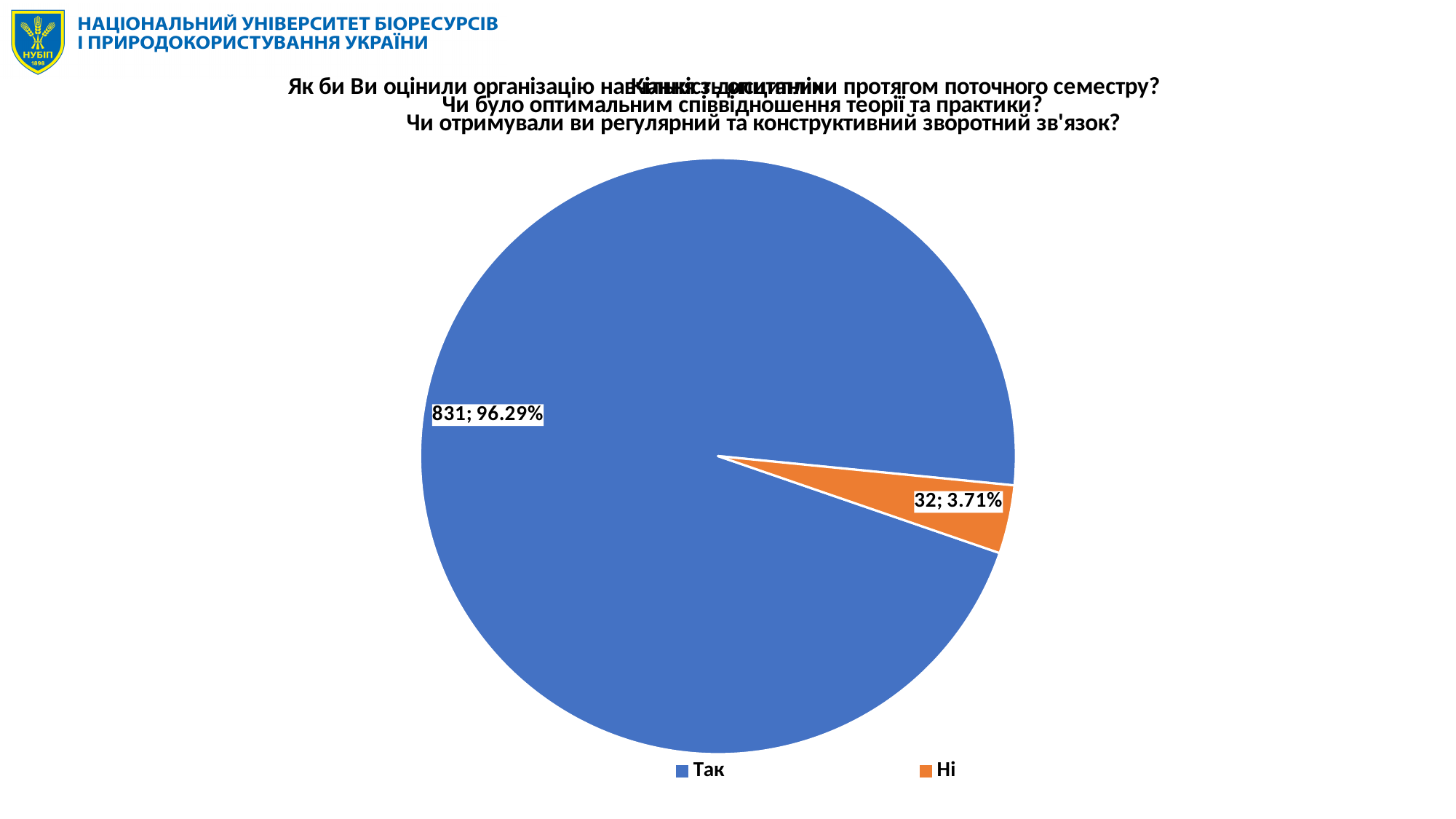
What is the count shown for the "Так" slice? 831 What colour is the "Ні" slice in the pie chart? orange Which slice is the smallest in the pie chart? Ні What is the count shown for the "Ні" slice? 32 Which slice is the largest in the pie chart? Так What kind of chart is shown on the slide? pie chart What is the difference between the counts for "Так" and "Ні"? 799 Which is larger, the "Так" slice or the "Ні" slice? Так How many entries does the legend of the pie chart list? 2 What share of the pie does the "Так" slice represent? 96.29% What share of the pie does the "Ні" slice represent? 3.71% How many slices does the pie chart have? 2